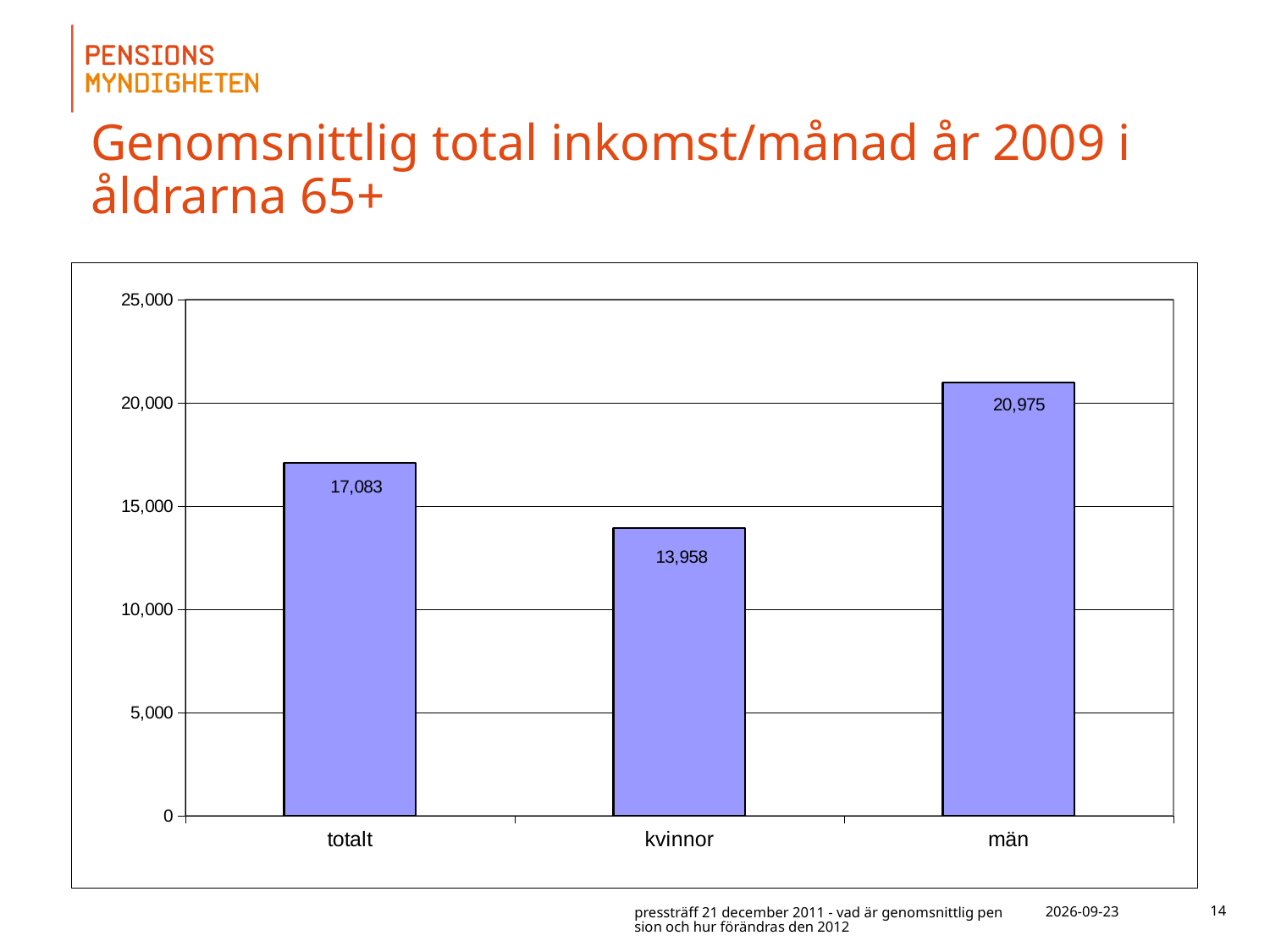
What kind of chart is shown on the slide? bar chart What is the value for totalt? 17,083 What is the difference between the values for män and kvinnor? 7,017 What is the title of the slide above the chart? Genomsnittlig total inkomst/månad år 2009 i åldrarna 65+ What is the value for kvinnor? 13,958 What is the difference between the values for totalt and kvinnor? 3,125 Which category has the lowest value? kvinnor Which category has the highest value? män Which is larger, the value for totalt or the value for kvinnor? totalt What is the value for män? 20,975 How many categories are shown on the x axis? 3 Is the value for män greater or less than 20,000? greater